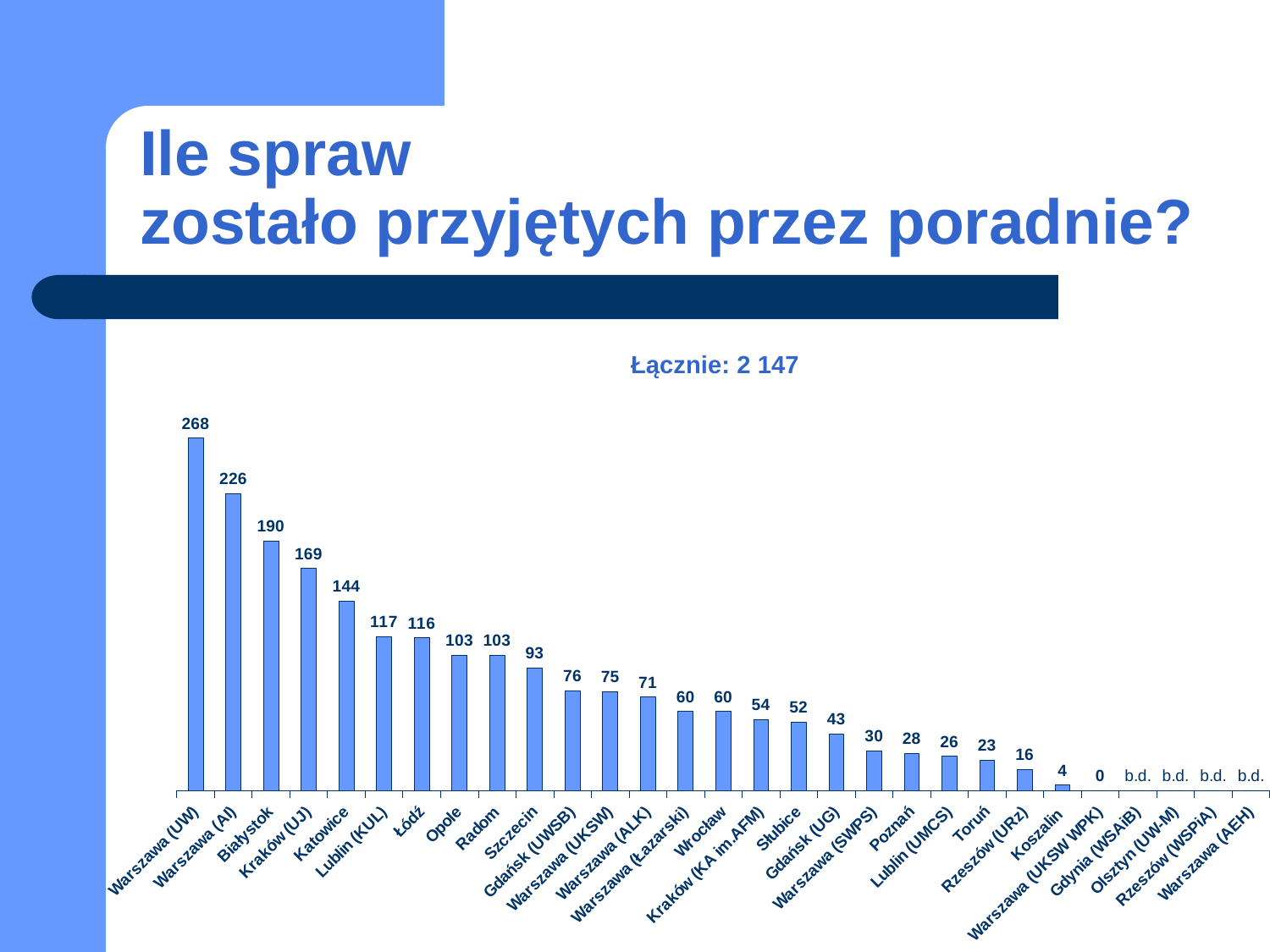
What value is shown for Warszawa (UW)? 268 What value is shown for Szczecin? 93 What value is shown for Koszalin? 4 Which is larger, the value for Poznań or the value for Toruń? Poznań What is shown for Gdynia (WSAiB)? b.d. What is the difference between the values for Białystok and Kraków (UJ)? 21 What total (Łącznie) is stated above the chart? 2 147 What is the difference between the values for Warszawa (UW) and Warszawa (AI)? 42 What value is shown for Katowice? 144 What kind of chart is shown on the slide? bar chart Which category has the highest value? Warszawa (UW) Which is larger, the value for Lublin (KUL) or the value for Łódź? Lublin (KUL)